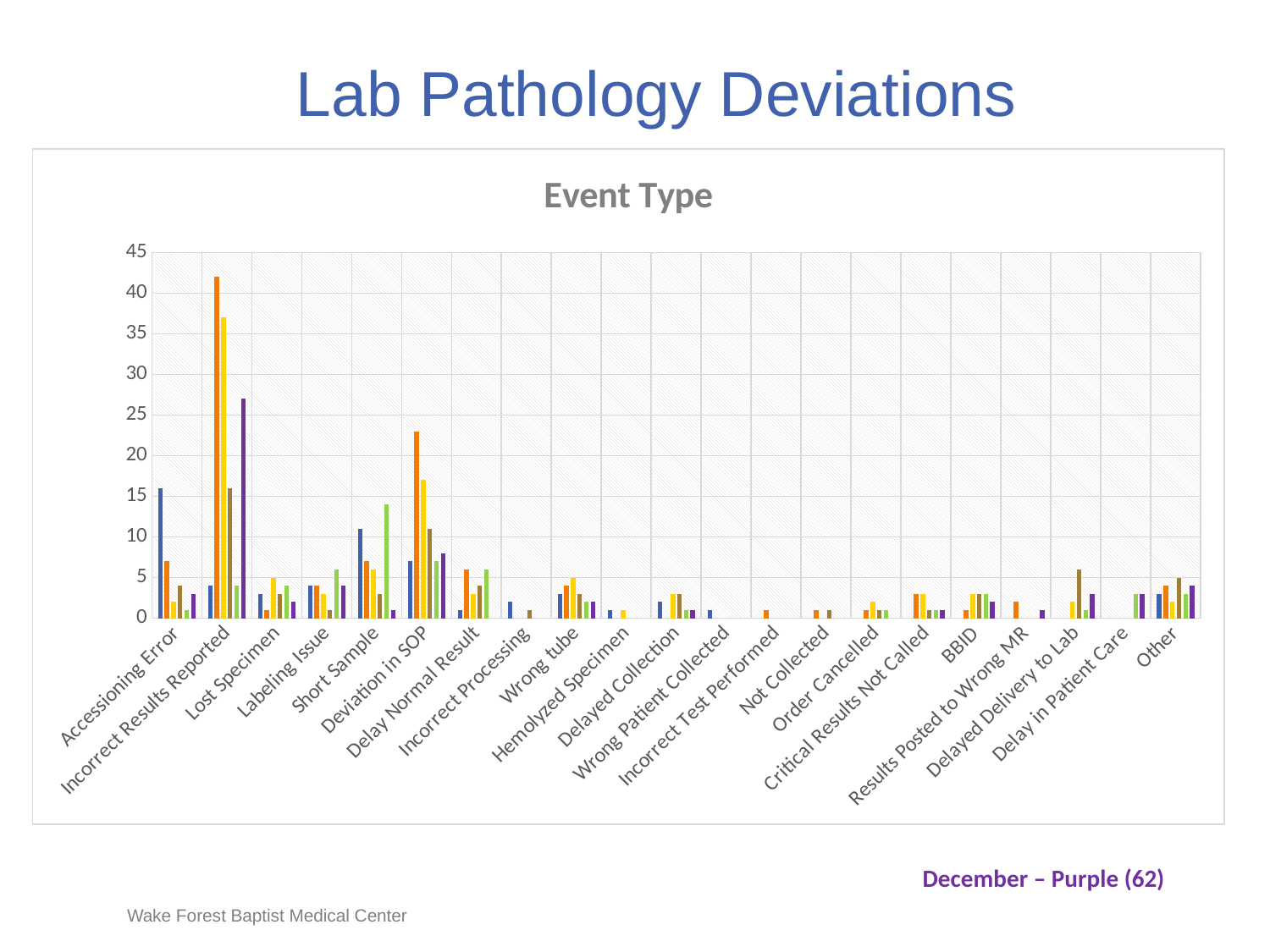
Is the purple (December) bar for Deviation in SOP greater or less than 10? less Which category has the taller tallest bar: Deviation in SOP or Short Sample? Deviation in SOP Is the purple (December) bar for Incorrect Results Reported greater or less than 20? greater Is the tallest bar in the Deviation in SOP category greater or less than 20? greater How many event type categories are shown on the x axis of the chart? 21 What type of chart is shown on the slide? bar chart Which event type category contains the tallest bar in the chart? Incorrect Results Reported What is the title of the chart? Event Type Which category has the taller purple (December) bar: Incorrect Results Reported or Deviation in SOP? Incorrect Results Reported What is the maximum value shown on the vertical axis of the chart? 45